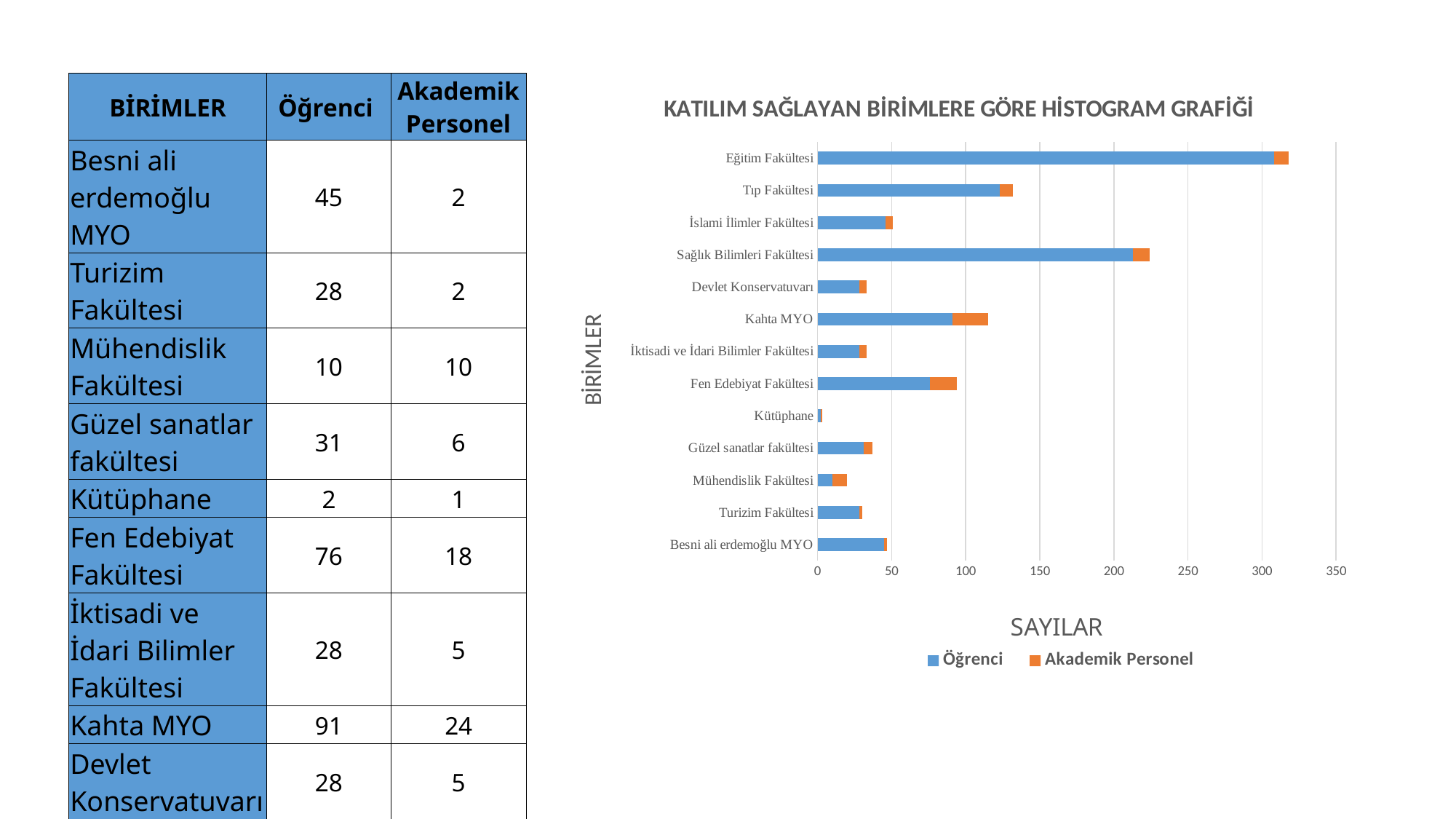
Is the Öğrenci value for Sağlık Bilimleri Fakültesi greater or less than 200? greater Which unit has the longest total bar on the chart? Eğitim Fakültesi How many series does the chart legend list? 2 What is the Akademik Personel value for Kahta MYO? 24 Which unit has the shortest total bar on the chart? Kütüphane Is the total bar for İslami İlimler Fakültesi greater or less than 100? less How many units (categories) are plotted on the chart? 13 Which has the longer total bar, Kahta MYO or Fen Edebiyat Fakültesi? Kahta MYO What kind of chart is shown on the slide? bar chart What is the title of the chart? KATILIM SAĞLAYAN BİRİMLERE GÖRE HİSTOGRAM GRAFİĞİ Is the total bar for Eğitim Fakültesi greater or less than 300? greater Which has the longer total bar, Sağlık Bilimleri Fakültesi or Tıp Fakültesi? Sağlık Bilimleri Fakültesi